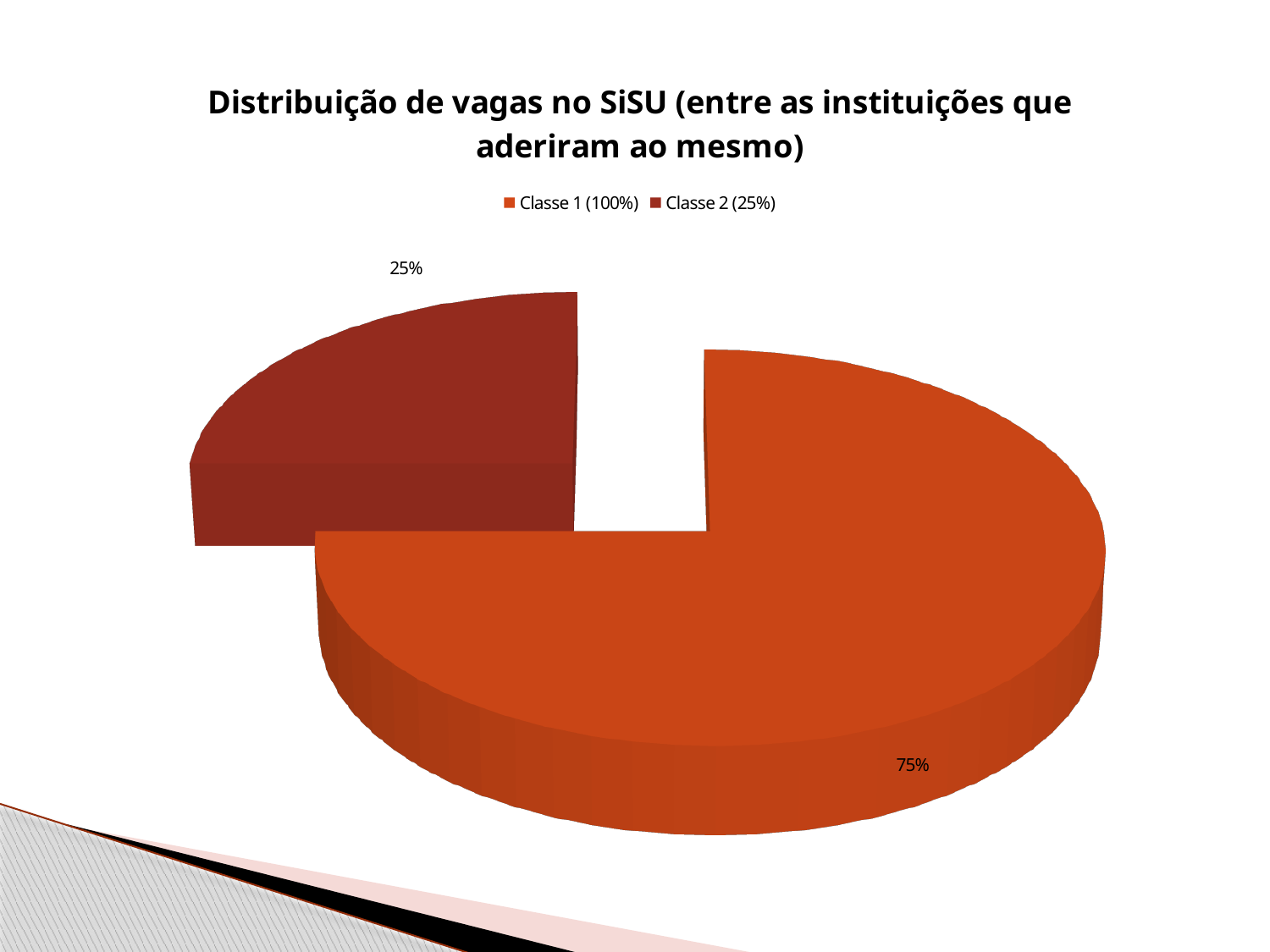
What is the difference between the shares of Classe 1 (100%) and Classe 2 (25%)? 50% What kind of chart is shown on the slide? Pie chart What share of the pie does Classe 2 (25%) represent? 25% Which slice is the largest? Classe 1 (100%) How many slices does the pie chart have? 2 How many entries does the legend list? 2 Which slice is the smallest? Classe 2 (25%) What is the title of the chart? Distribuição de vagas no SiSU (entre as instituições que aderiram ao mesmo) What share of the pie does Classe 1 (100%) represent? 75% Which is larger, the share for Classe 1 (100%) or for Classe 2 (25%)? Classe 1 (100%) What are the two legend entries of the chart? Classe 1 (100%) and Classe 2 (25%)